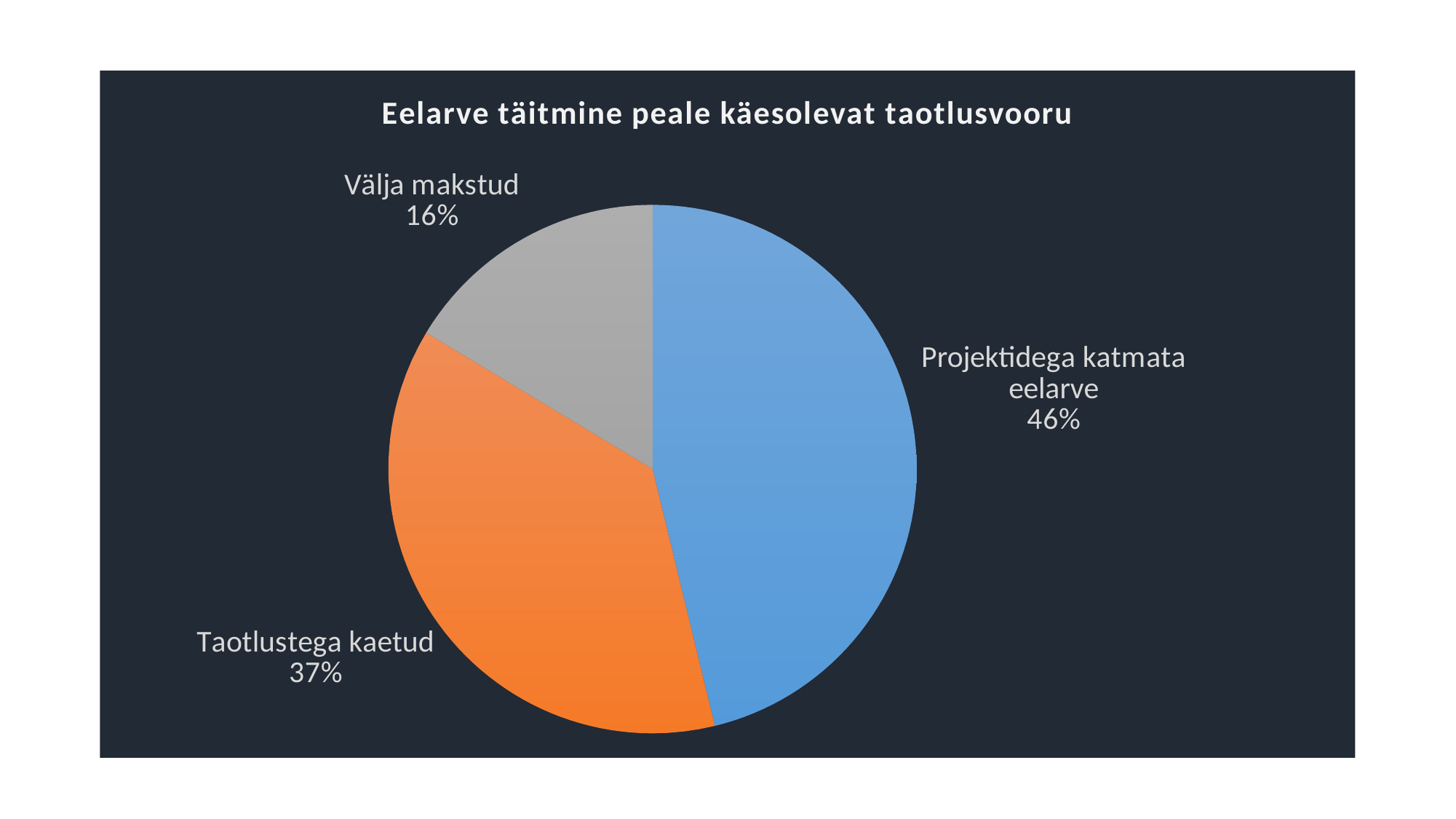
What share of the pie is labelled "Välja makstud"? 16% What share of the pie is labelled "Projektidega katmata eelarve"? 46% How many slices does the pie chart have? 3 Which slice of the pie is the smallest? Välja makstud What is the difference in percentage points between "Projektidega katmata eelarve" and "Taotlustega kaetud"? 9 What is the difference in percentage points between "Taotlustega kaetud" and "Välja makstud"? 21 Which slice of the pie is the largest? Projektidega katmata eelarve What is the title of the chart? Eelarve täitmine peale käesolevat taotlusvooru What colour is the "Taotlustega kaetud" slice? orange What kind of chart is shown on the slide? pie chart What share of the pie is labelled "Taotlustega kaetud"? 37% Which is larger, the share for "Taotlustega kaetud" or the share for "Välja makstud"? Taotlustega kaetud